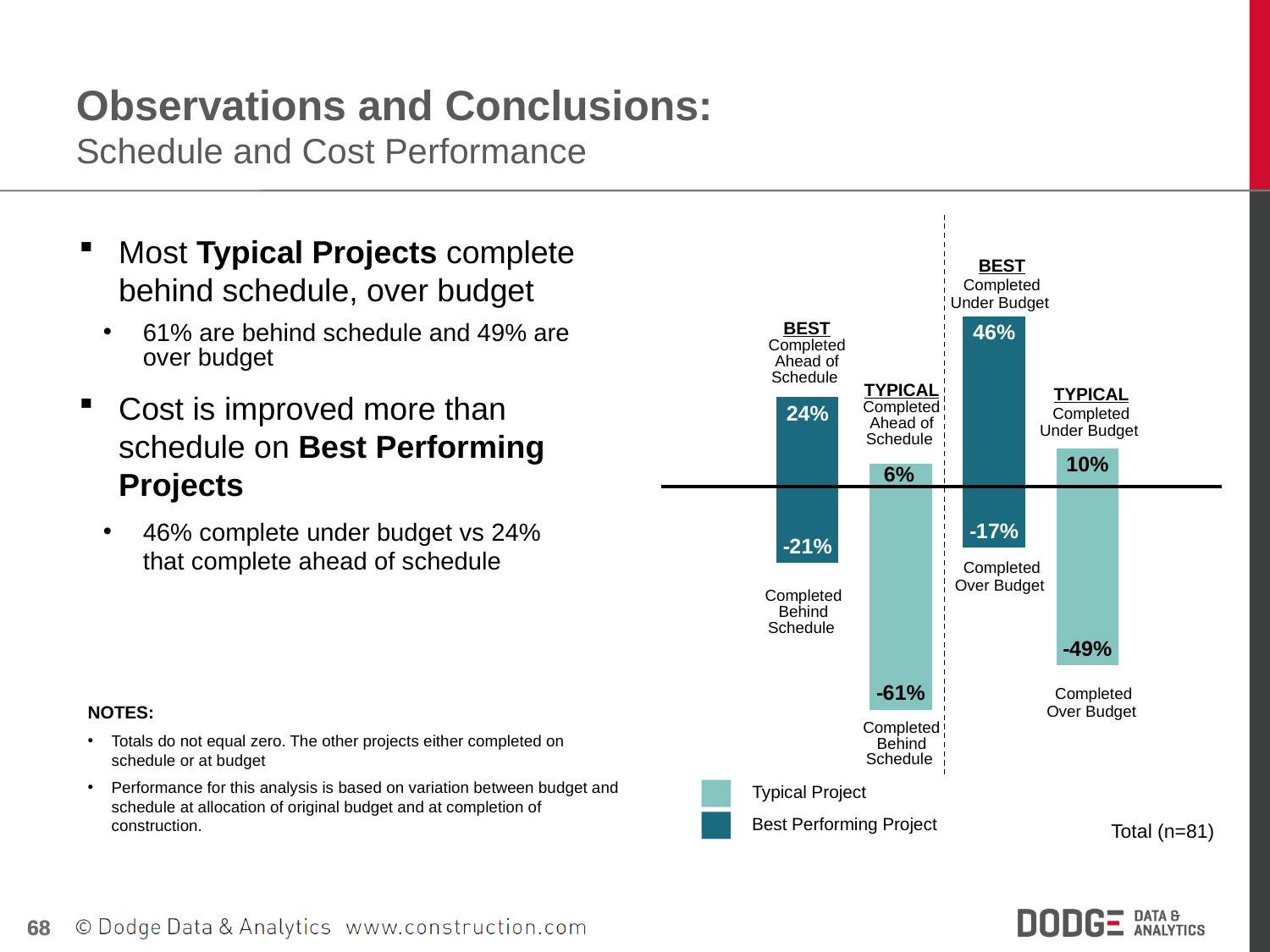
What value is shown for Typical Projects completed under budget? 10% Which bar has the lowest (most negative) value on the chart? TYPICAL Completed Behind Schedule (-61%) Which is larger: the Typical Project completed ahead of schedule value or the Typical Project completed under budget value? Completed under budget (10%) What is the difference between the Best Performing Project completed under budget value and the Best Performing Project completed ahead of schedule value? 22 percentage points What percentage of Best Performing Projects completed ahead of schedule? 24% What percentage of Typical Projects completed over budget? -49% What percentage of Typical Projects completed behind schedule? -61% What type of chart is shown on the slide? Bar chart How many series does the chart legend list? 2 Which bar has the highest positive value on the chart? BEST Completed Under Budget (46%) What percentage of Best Performing Projects completed under budget? 46% What value is shown for Best Performing Projects completed over budget? -17%